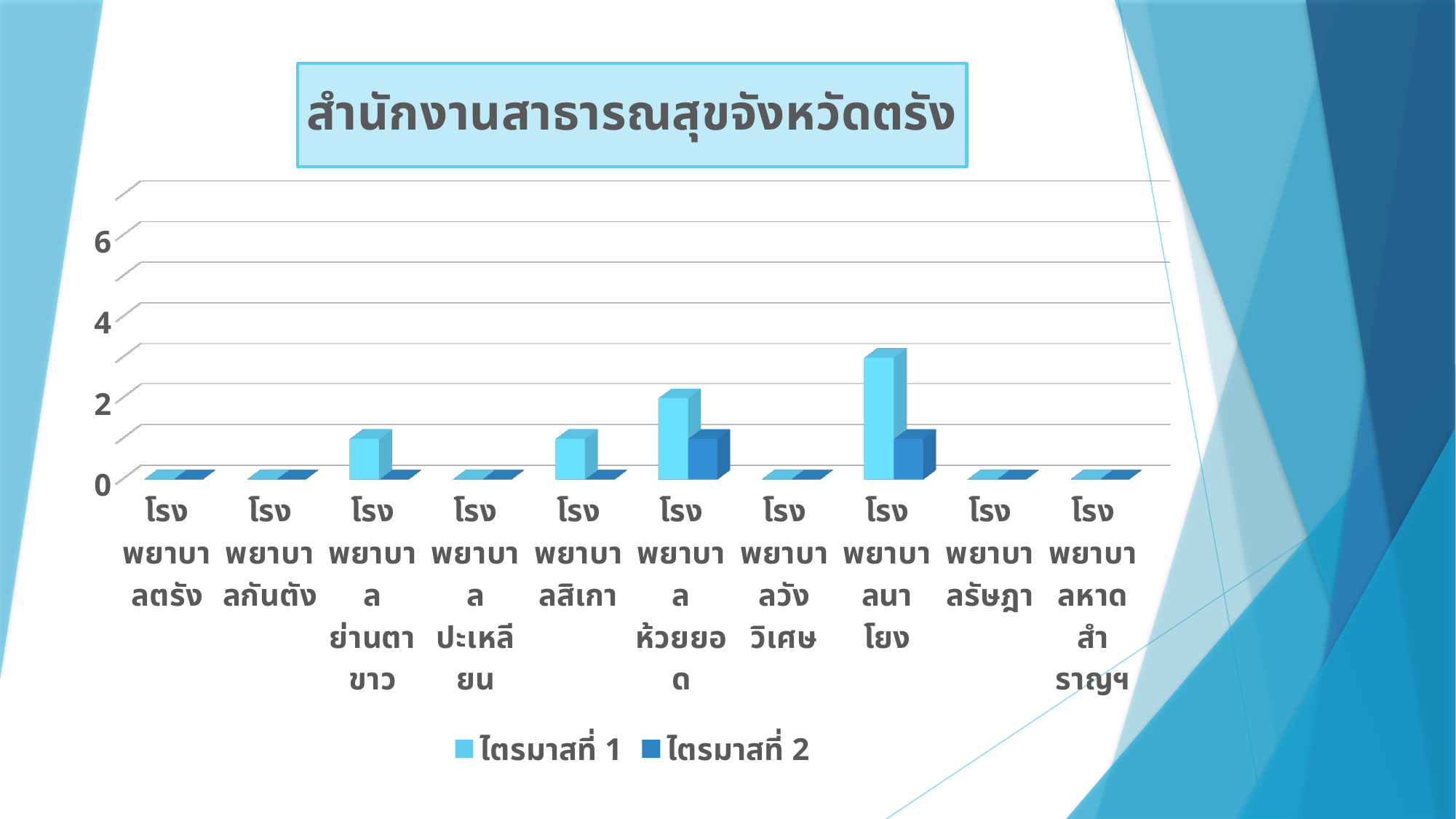
Is the ไตรมาสที่ 1 value for โรงพยาบาลนาโยง greater or less than 2? greater Which is larger for ไตรมาสที่ 1: โรงพยาบาลนาโยง or โรงพยาบาลห้วยยอด? โรงพยาบาลนาโยง Which hospital has the highest value for ไตรมาสที่ 1? โรงพยาบาลนาโยง How many series does the legend list? 2 What is the title of the chart? สำนักงานสาธารณสุขจังหวัดตรัง How many hospital categories are shown on the x axis? 10 Is the ไตรมาสที่ 1 value for โรงพยาบาลห้วยยอด greater or less than 4? less What are the two series named in the legend? ไตรมาสที่ 1 and ไตรมาสที่ 2 Is the ไตรมาสที่ 1 value for โรงพยาบาลย่านตาขาว greater or less than 2? less What kind of chart is shown on the slide? bar chart For โรงพยาบาลนาโยง, which series has the larger value: ไตรมาสที่ 1 or ไตรมาสที่ 2? ไตรมาสที่ 1